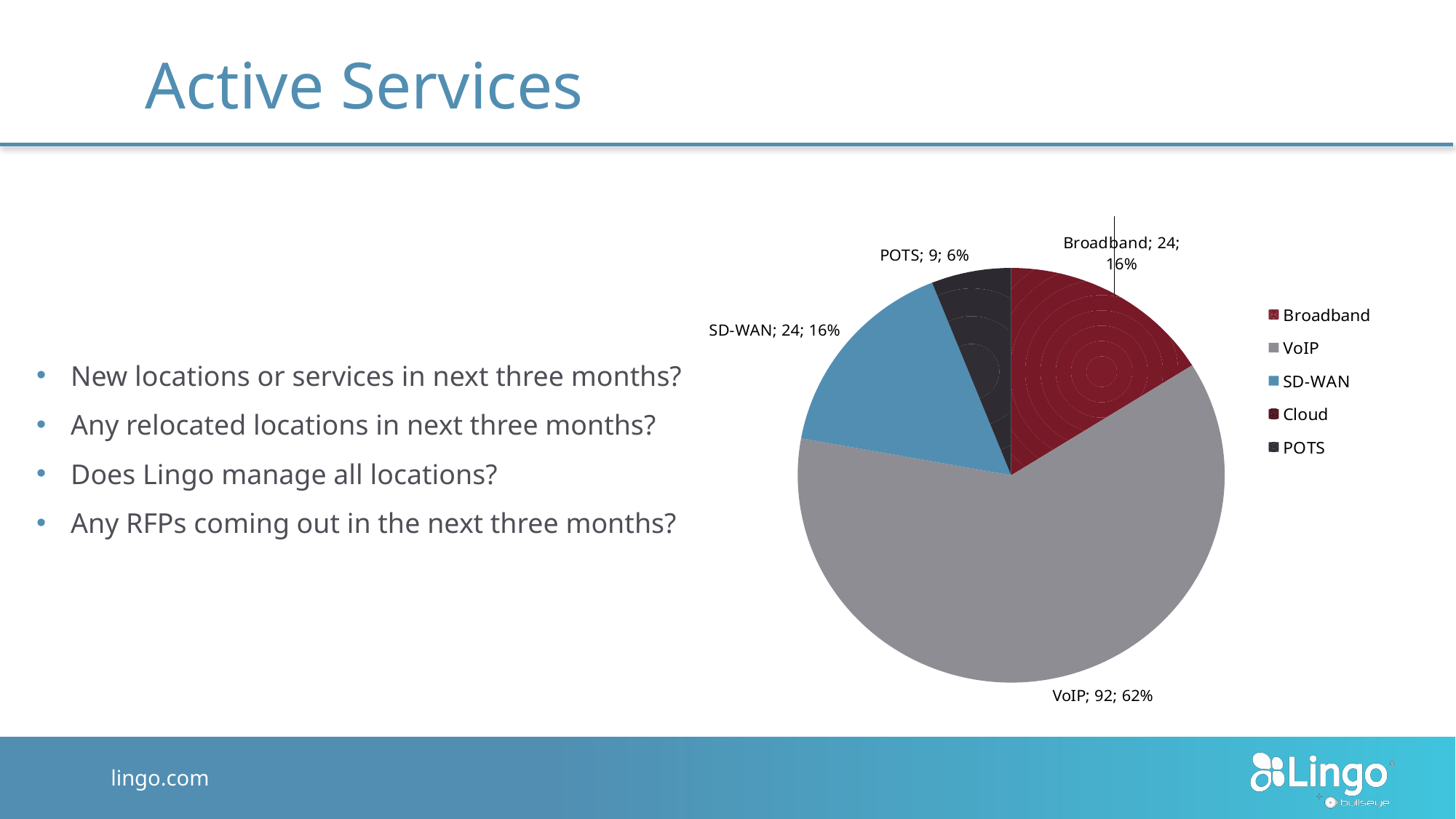
What is the value for POTS in the pie chart? 9 What type of chart is shown on the slide? pie chart What percentage share of the pie does SD-WAN have? 16% What is the difference between the VoIP value and the SD-WAN value? 68 Which is larger, the value for Broadband or the value for POTS? Broadband What percentage share of the pie does VoIP have? 62% Which labelled category has the smallest slice in the pie chart? POTS What colour is the VoIP slice in the pie chart? grey Which category has the largest slice in the pie chart? VoIP What is the value for VoIP in the pie chart? 92 What is the value for Broadband in the pie chart? 24 How many entries does the legend of the pie chart list? 5